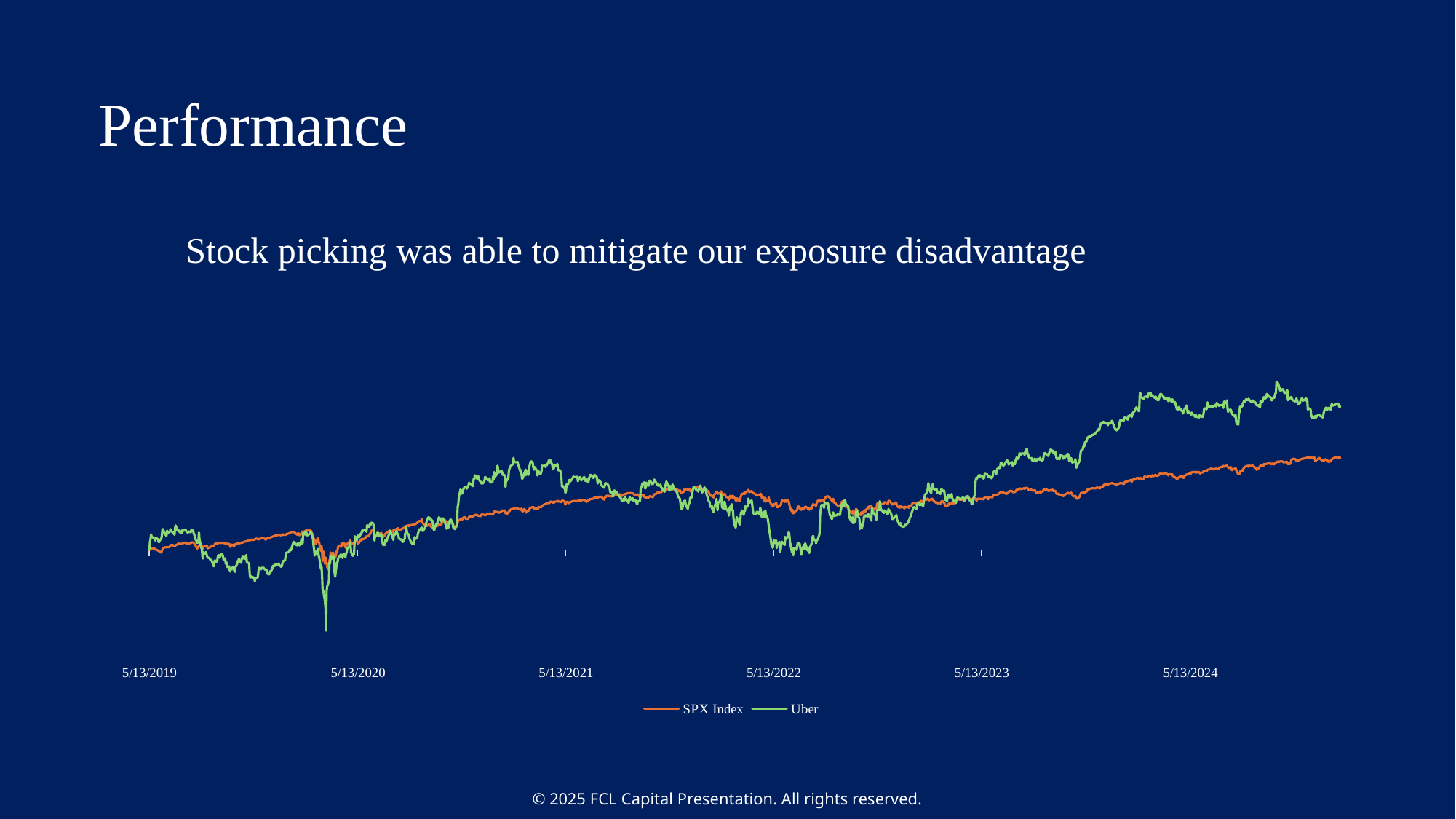
What is the last date label on the x axis of the chart? 5/13/2024 At the right end of the chart, which series is higher, SPX Index or Uber? Uber What kind of chart is shown on the slide? Line chart What are the two series named in the chart's legend? SPX Index and Uber How many series does the chart's legend list? 2 Does the SPX Index line generally rise or fall from 5/13/2019 to 5/13/2024? Rise Which colour is used for the Uber line in the chart? Green How many date labels are shown along the x axis of the chart? 6 What is the first date label on the x axis of the chart? 5/13/2019 Around 5/13/2022, which series is lower, SPX Index or Uber? Uber Which series reaches the lowest point on the chart? Uber Which series reaches the highest point on the chart? Uber